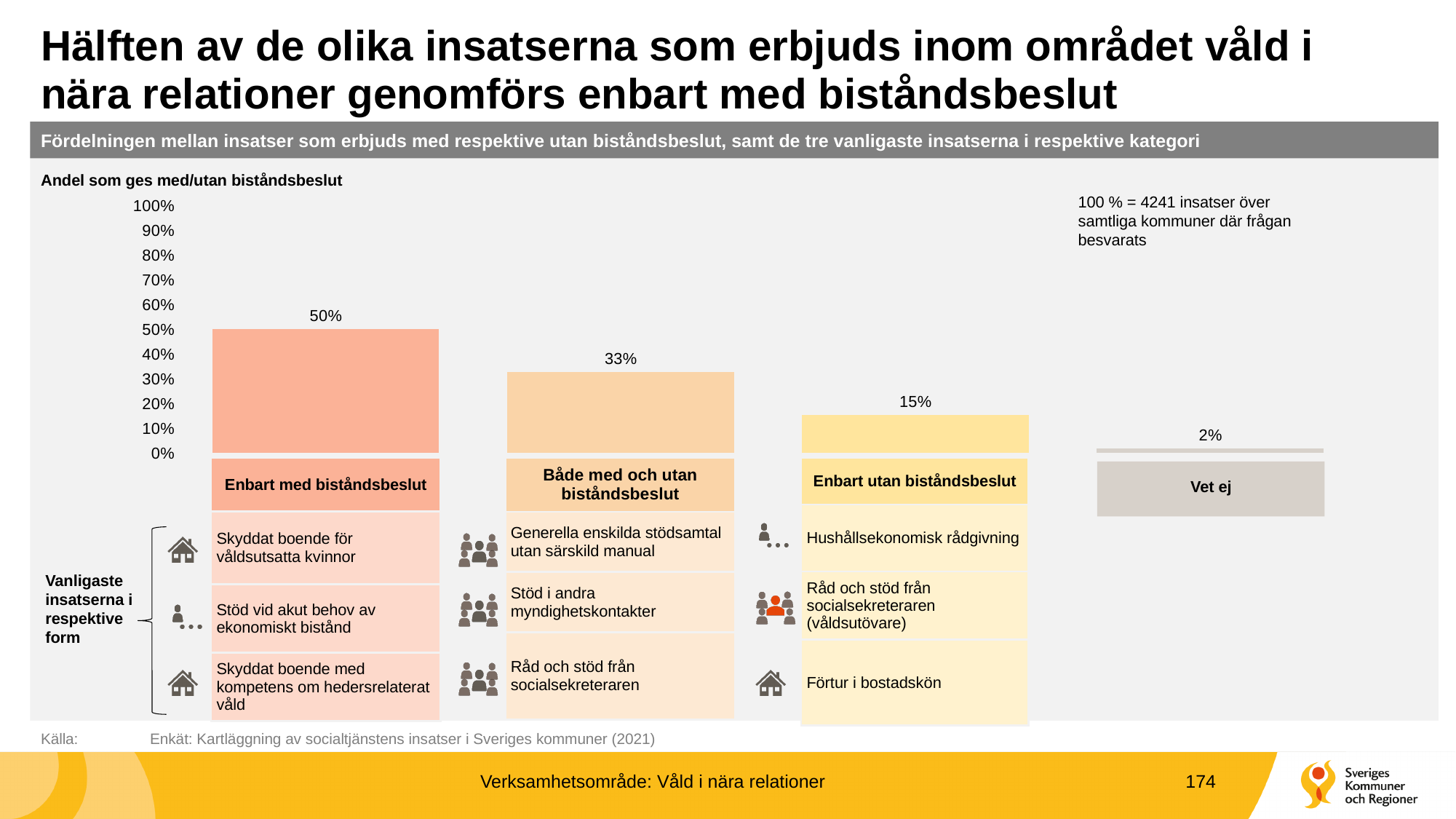
What is the difference between 'Enbart med biståndsbeslut' and 'Både med och utan biståndsbeslut'? 17% Which category has the highest value? Enbart med biståndsbeslut Which category has the lowest value? Vet ej What is the value for 'Enbart med biståndsbeslut'? 50% What is the difference between 'Enbart utan biståndsbeslut' and 'Vet ej'? 13% What is the value for 'Både med och utan biståndsbeslut'? 33% What is the value for 'Enbart utan biståndsbeslut'? 15% What is the highest value shown on the y axis? 100% What is the value for 'Vet ej'? 2% How many categories are shown in the bar chart? 4 What kind of chart is shown on the slide? Bar chart Which is larger, 'Både med och utan biståndsbeslut' or 'Enbart utan biståndsbeslut'? Både med och utan biståndsbeslut